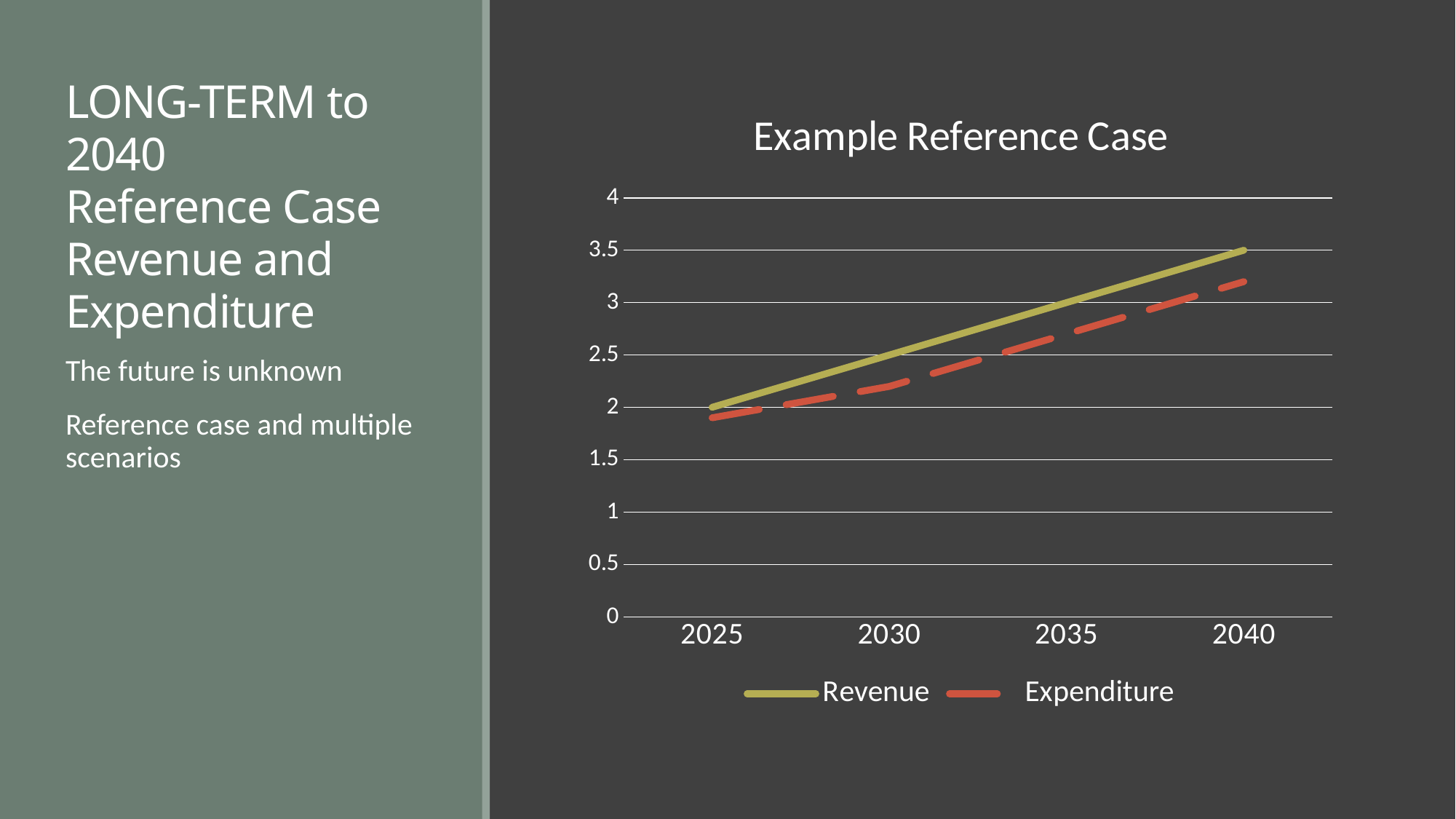
What is the Revenue value in 2040? 3.5 In 2040, which is larger, Revenue or Expenditure? Revenue Does Revenue rise or fall from 2025 to 2040? rise What is the Revenue value in 2025? 2 Is the Expenditure value in 2040 greater or less than 3? greater What kind of chart is shown on the slide? line chart How many series does the legend list? 2 Is the Expenditure value in 2025 greater or less than 2? less How many years are shown on the x axis? 4 What is the title of the chart? Example Reference Case Does Expenditure rise or fall from 2025 to 2040? rise By how much does Revenue increase from 2025 to 2040? 1.5